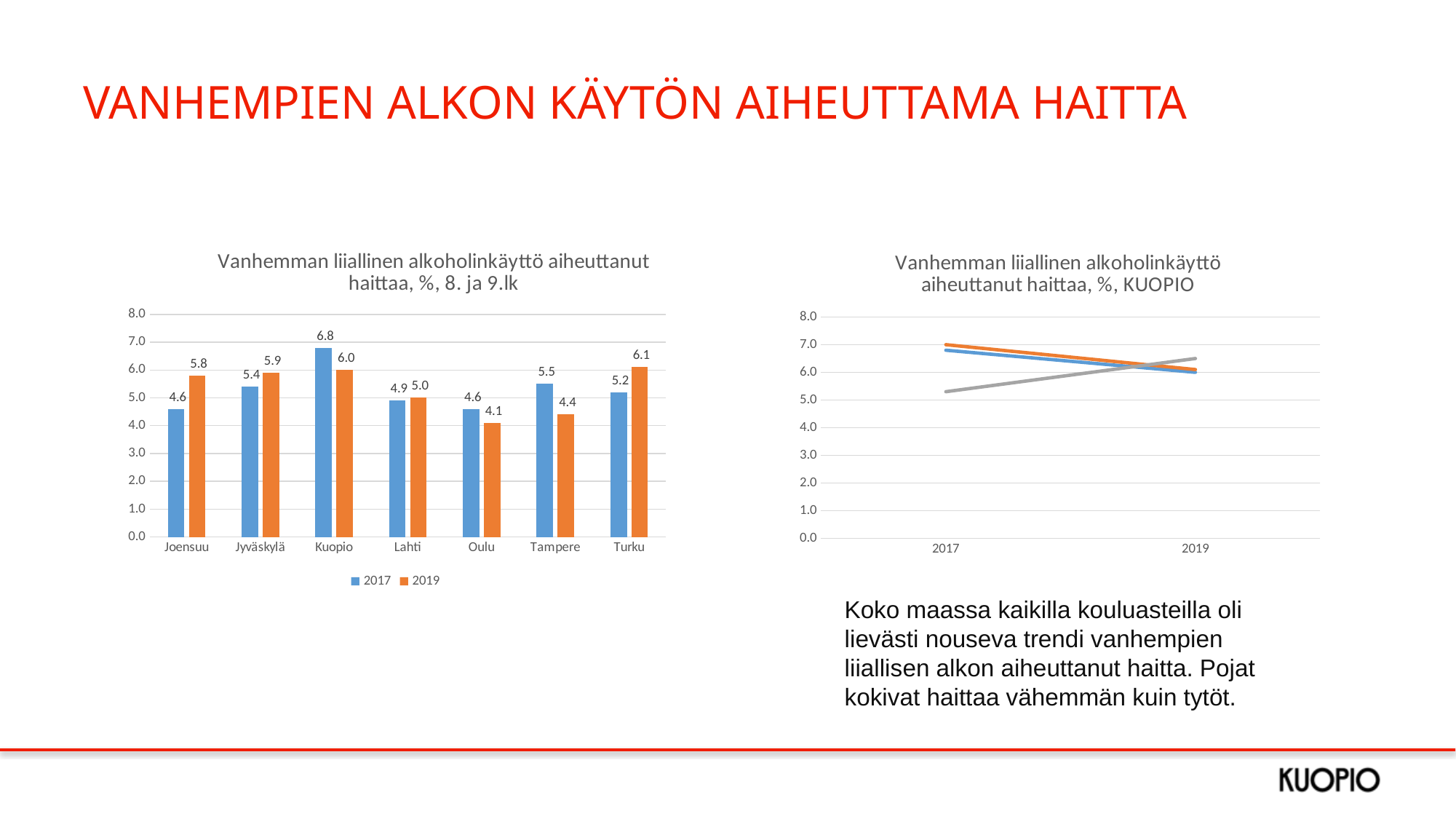
In the left chart (8. ja 9.lk), what is the 2019 value for Oulu? 4.1 In the left chart (8. ja 9.lk), how many series does the legend list? 2 In the left chart (8. ja 9.lk), which city has the highest 2017 value? Kuopio What kind of chart is the right chart (KUOPIO)? Line chart What kind of chart is the left chart (8. ja 9.lk)? Bar chart In the left chart (8. ja 9.lk), which is larger for Tampere: the 2017 value or the 2019 value? 2017 In the right chart (KUOPIO), does the gray line rise or fall from 2017 to 2019? Rises In the left chart (8. ja 9.lk), what is the 2017 value for Kuopio? 6.8 In the left chart (8. ja 9.lk), what is the 2019 value for Turku? 6.1 In the left chart (8. ja 9.lk), what is the difference between the 2017 and 2019 values for Joensuu? 1.2 In the left chart (8. ja 9.lk), which city has the lowest 2019 value? Oulu In the left chart (8. ja 9.lk), how many cities are shown on the x axis? 7